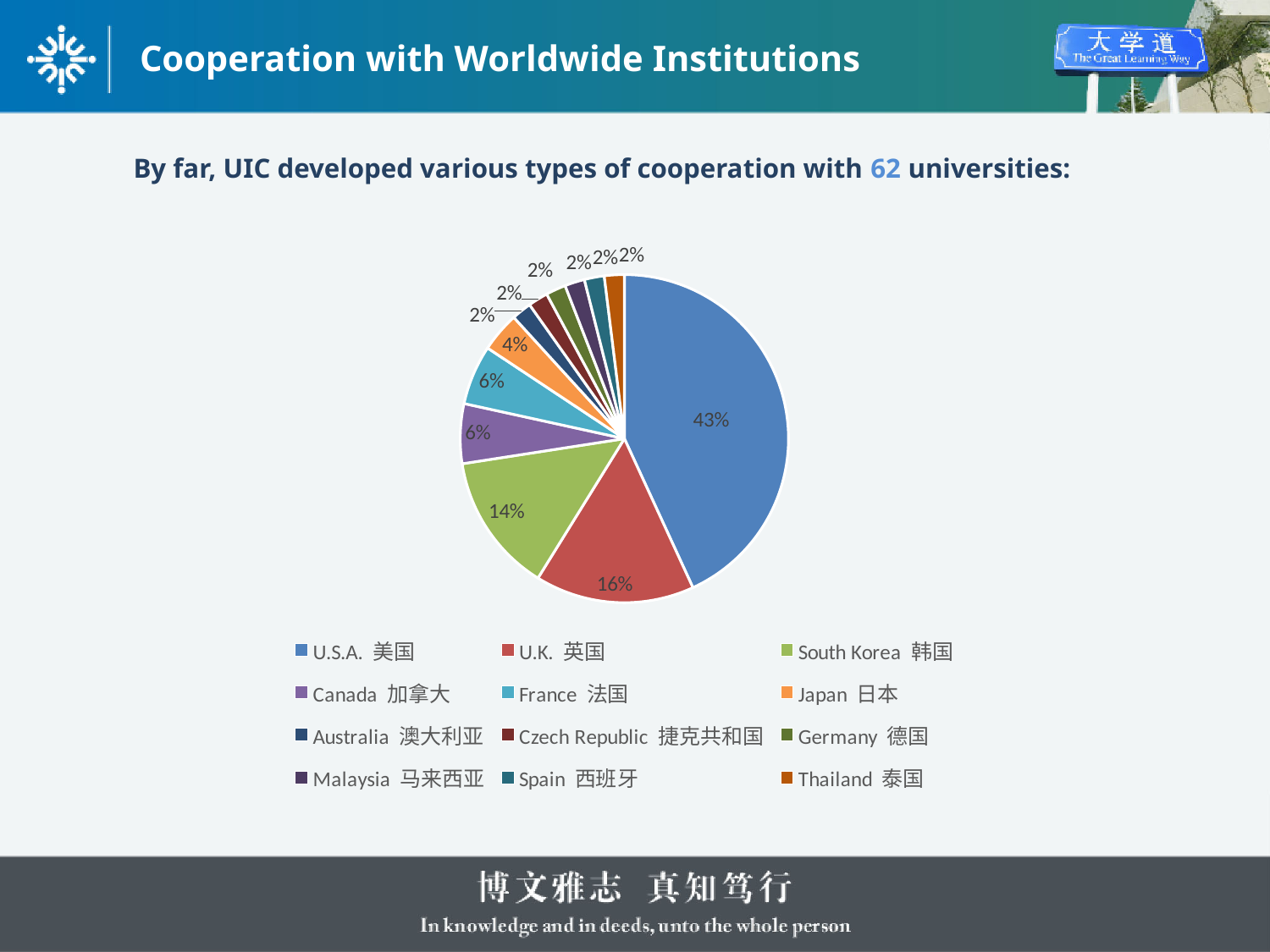
How many entries does the legend list? 12 What percentage is shown for U.K.? 16% Which country has the largest slice of the pie? U.S.A. What percentage is shown for Japan? 4% What is the difference in percentage points between the U.S.A. slice and the U.K. slice? 27% What percentage is shown for South Korea? 14% Which country is represented by the red slice in the pie chart? U.K. What percentage is shown for Canada? 6% What kind of chart is shown on the slide? pie chart Which is larger, the share for U.K. or the share for South Korea? U.K. What share of the pie does U.S.A. account for? 43% How many countries are shown in the pie chart? 12